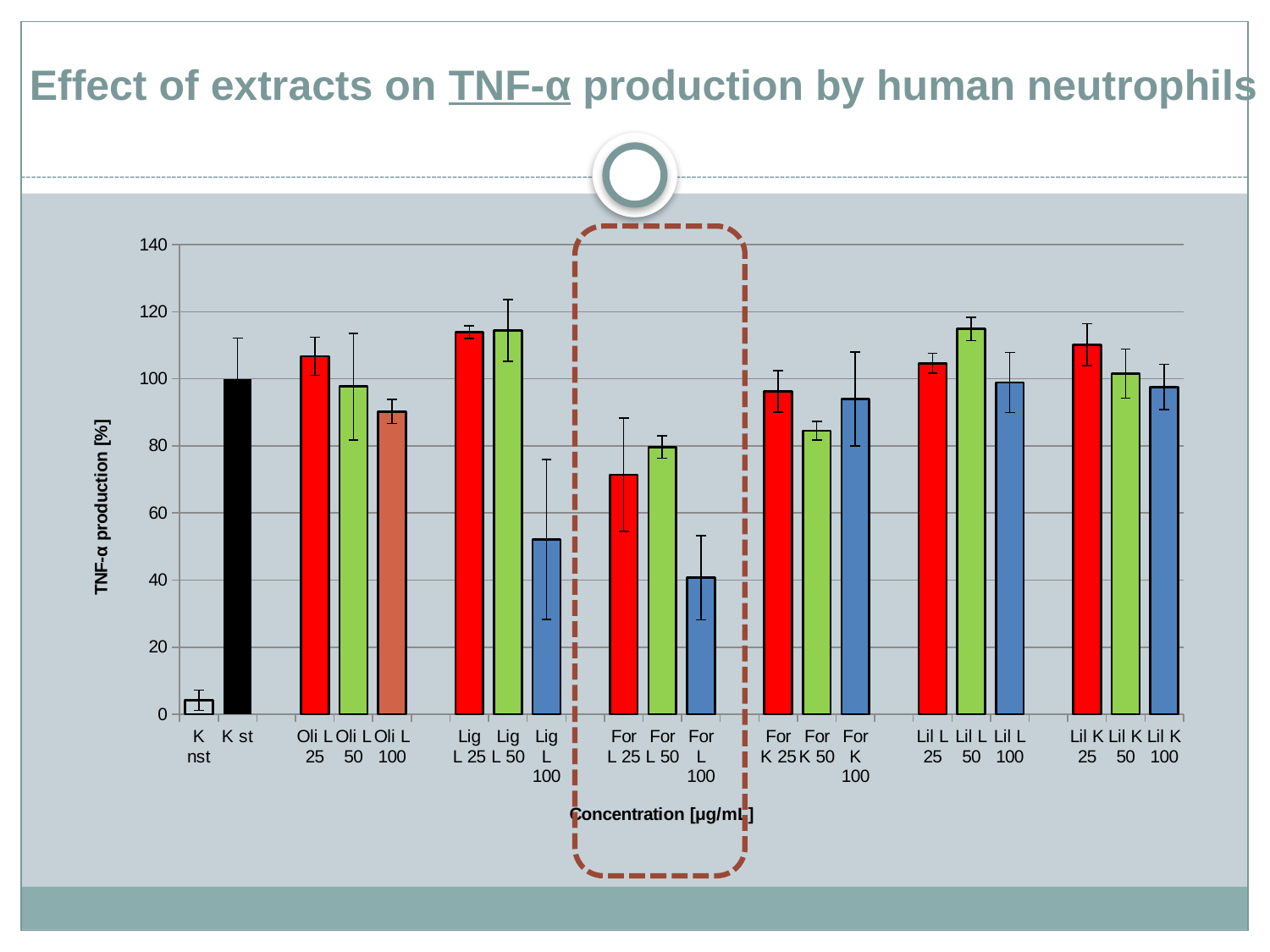
What is the label of the x axis? Concentration [µg/mL] What kind of chart is shown on the slide? bar chart What is the label of the y axis? TNF-α production [%] Is the value for K nst greater or less than 20? less Which is larger, the value for For L 100 or For K 100? For K 100 Which category has the lowest TNF-α production? K nst How many bars are plotted in the chart? 20 Is the value for For L 25 greater or less than 80? less Is the value for Oli L 25 greater or less than 100? greater Which is larger, the value for Oli L 25 or Oli L 100? Oli L 25